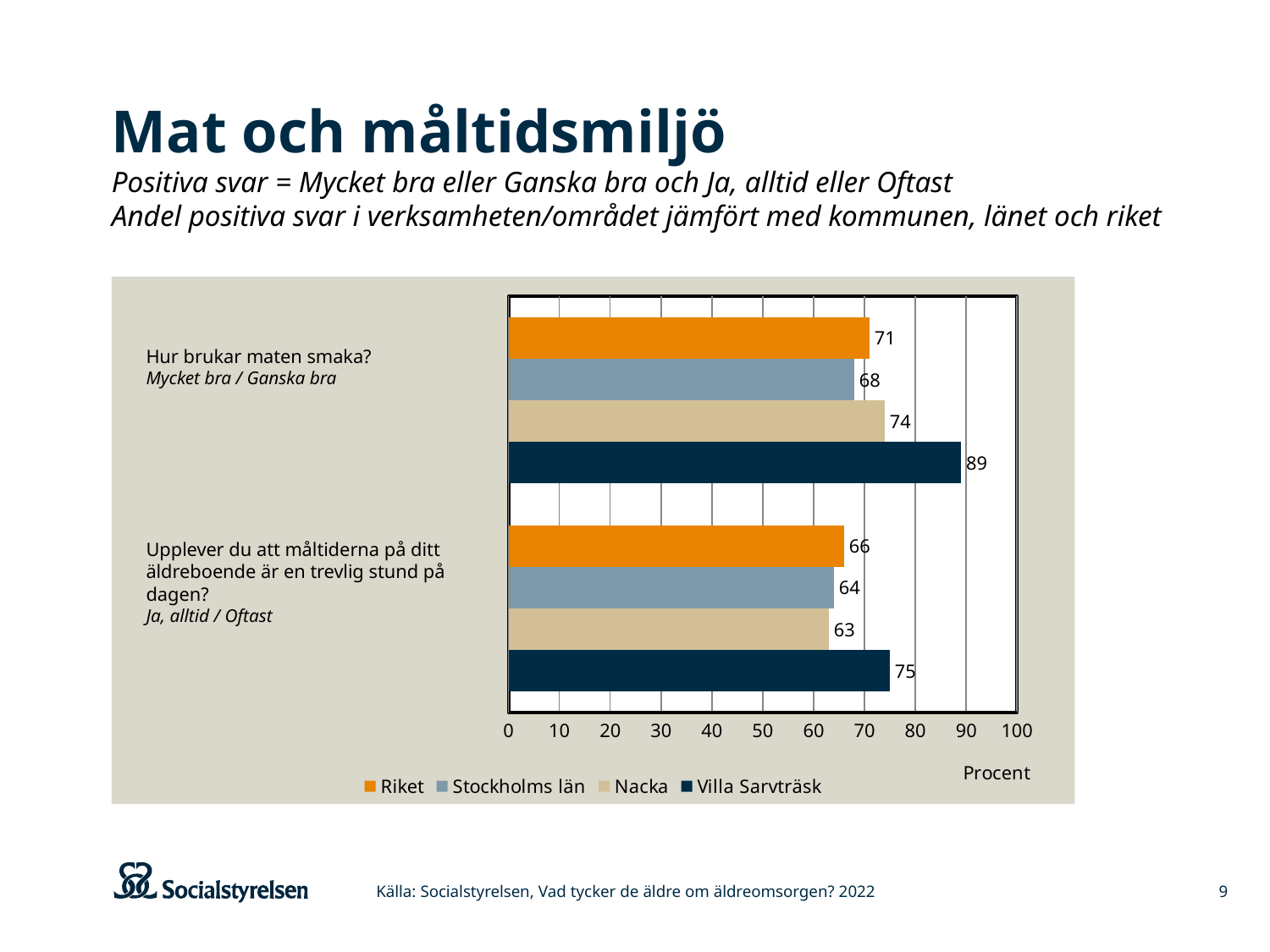
How many questions (categories) are shown in the chart? 2 What is the value for Villa Sarvträsk on the question 'Hur brukar maten smaka?' 89 What is the difference between Villa Sarvträsk and Riket on 'Hur brukar maten smaka?' 18 Which series has the highest value for 'Hur brukar maten smaka?' Villa Sarvträsk What is the value for Nacka on the question 'Upplever du att måltiderna på ditt äldreboende är en trevlig stund på dagen?' 63 What unit is shown on the x axis of the chart? Procent What is the difference between Villa Sarvträsk and Stockholms län on 'Upplever du att måltiderna på ditt äldreboende är en trevlig stund på dagen?' 11 Which is larger for 'Hur brukar maten smaka?': Riket or Nacka? Nacka What kind of chart is shown on the slide? Bar chart What is the value for Stockholms län on the question 'Hur brukar maten smaka?' 68 How many series does the legend list? 4 Which series has the lowest value for 'Upplever du att måltiderna på ditt äldreboende är en trevlig stund på dagen?' Nacka